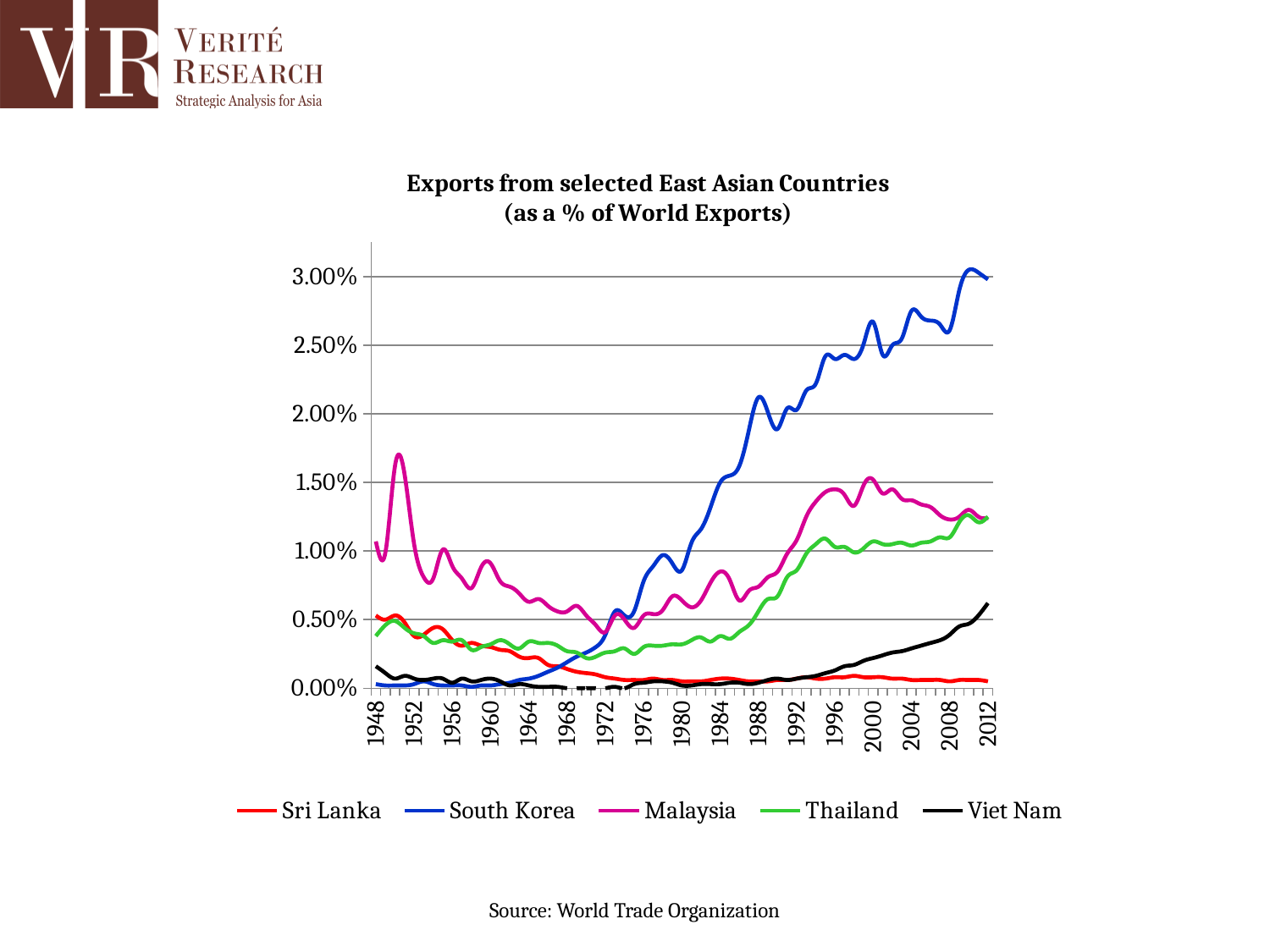
Is the value for Sri Lanka in 2012 greater or less than 0.50%? less Is the value for South Korea in 2012 greater or less than 2.50%? greater In 1996, which is larger: the value for Malaysia or the value for Thailand? Malaysia Is the value for Viet Nam in 2012 greater or less than 0.50%? greater What is the source cited below the chart? World Trade Organization What kind of chart is shown on the slide? Line chart Which countries are listed in the chart's legend? Sri Lanka, South Korea, Malaysia, Thailand, Viet Nam How many series does the legend list? 5 Which country has the highest share of world exports in 2012? South Korea Which country has the lowest share of world exports in 2012? Sri Lanka Does South Korea's share of world exports rise or fall overall from 1948 to 2012? rise